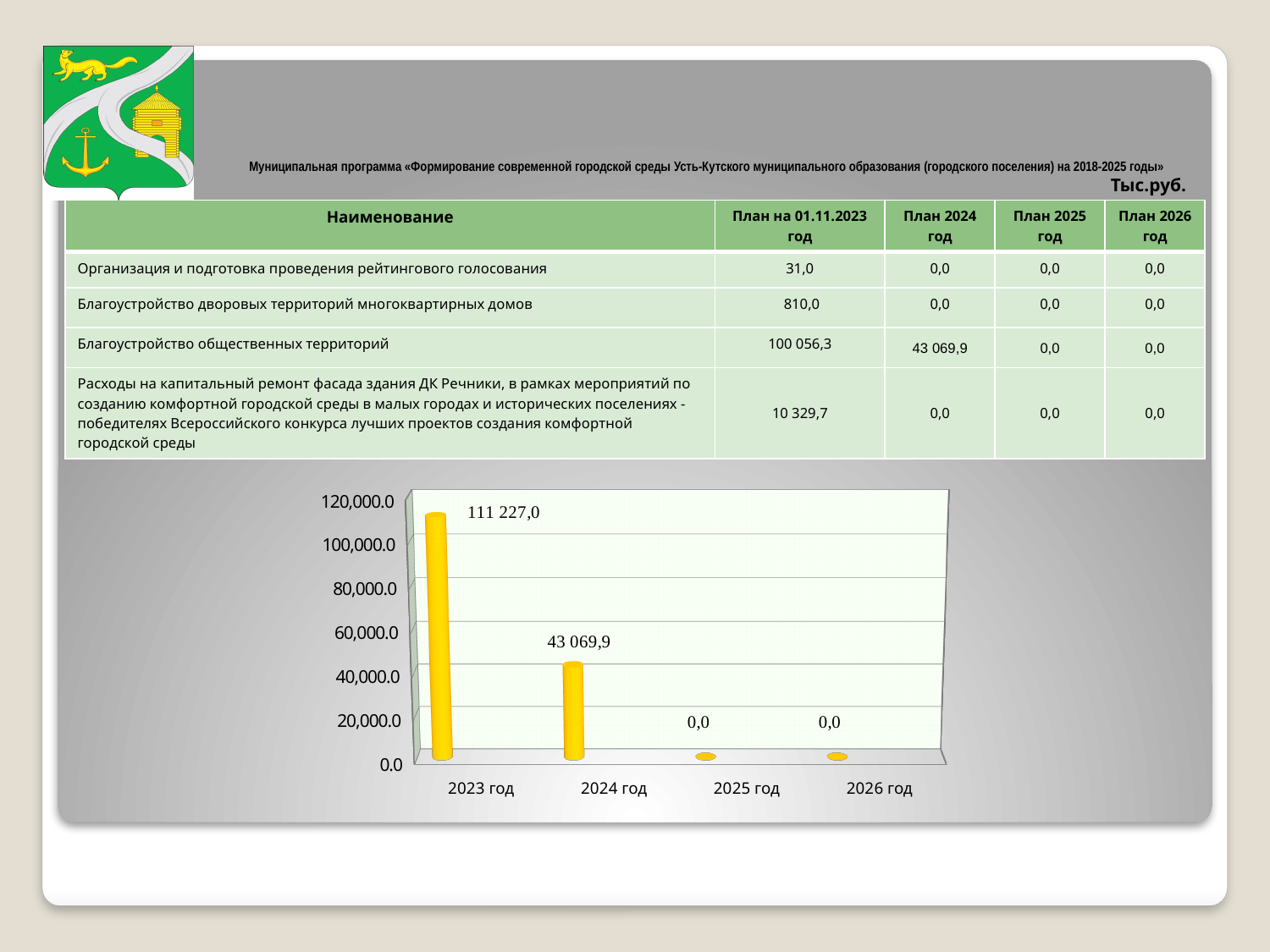
What is the value shown for 2025 год in the chart? 0,0 Which of the two, 2023 год or 2024 год, has the larger value in the chart? 2023 год What is the value shown for 2024 год in the chart? 43 069,9 How many categories are shown on the x axis of the chart? 4 Do the values rise or fall from 2023 год to 2025 год along the x axis? fall What is the difference between the values for 2023 год and 2024 год in the chart? 68 157,1 Is the value for 2024 год greater or less than 60,000.0? less What is the value shown for 2023 год in the chart? 111 227,0 What is the value shown for 2026 год in the chart? 0,0 Which year has the highest value in the chart? 2023 год Is the value for 2023 год greater or less than 100,000.0? greater What kind of chart is shown on the slide? bar chart